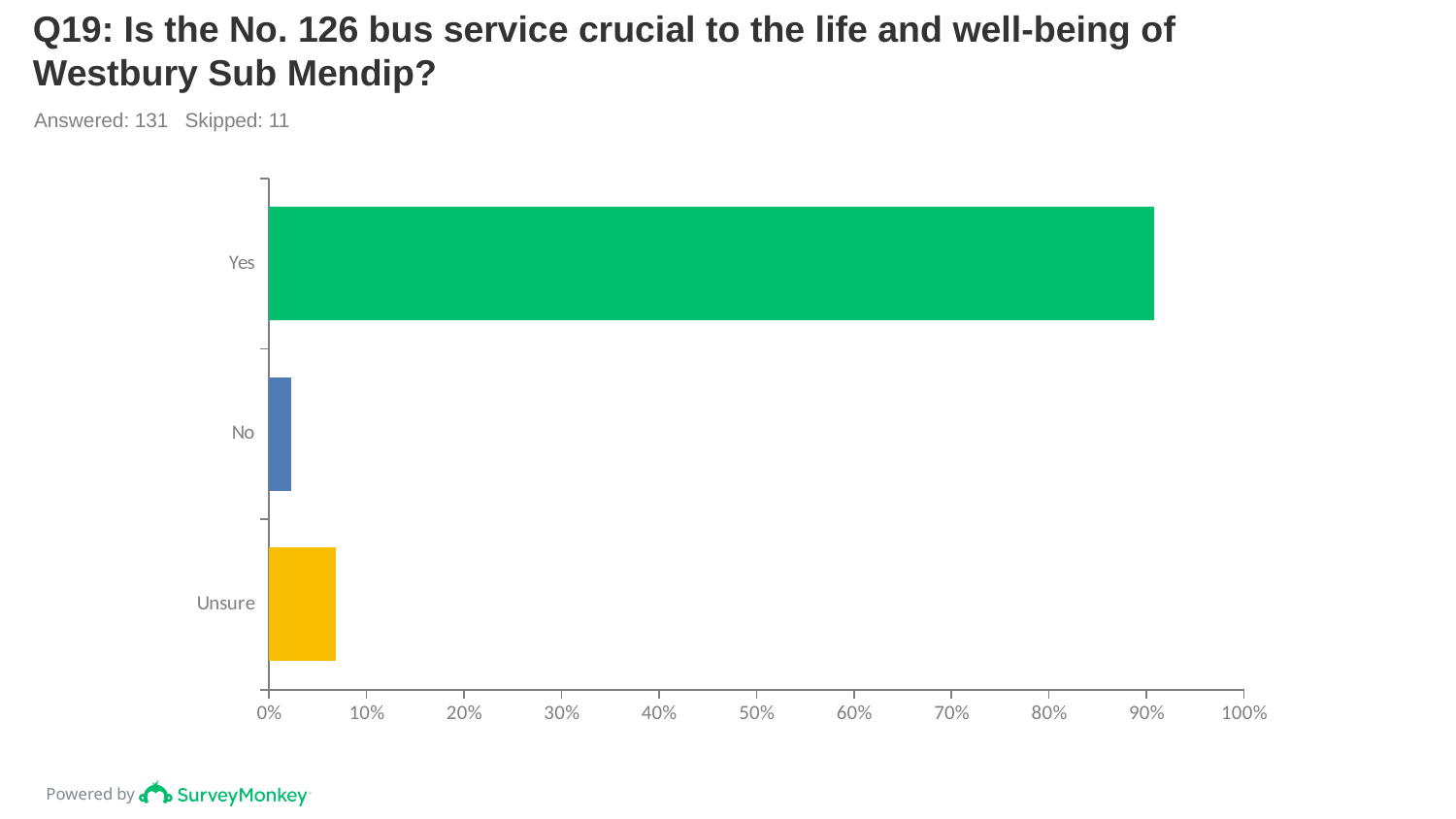
What kind of chart is shown on the slide? bar chart Which category has the lowest value? No What colour is the bar for Yes? green Is the value for Yes greater or less than 80%? greater Is the value for Unsure greater or less than 10%? less Which is larger, the value for Unsure or the value for No? Unsure Which category has the highest value? Yes Is the value for No greater or less than 10%? less What is the maximum value shown on the horizontal axis? 100% Which is larger, the value for Yes or the value for Unsure? Yes How many categories are plotted on the chart? 3